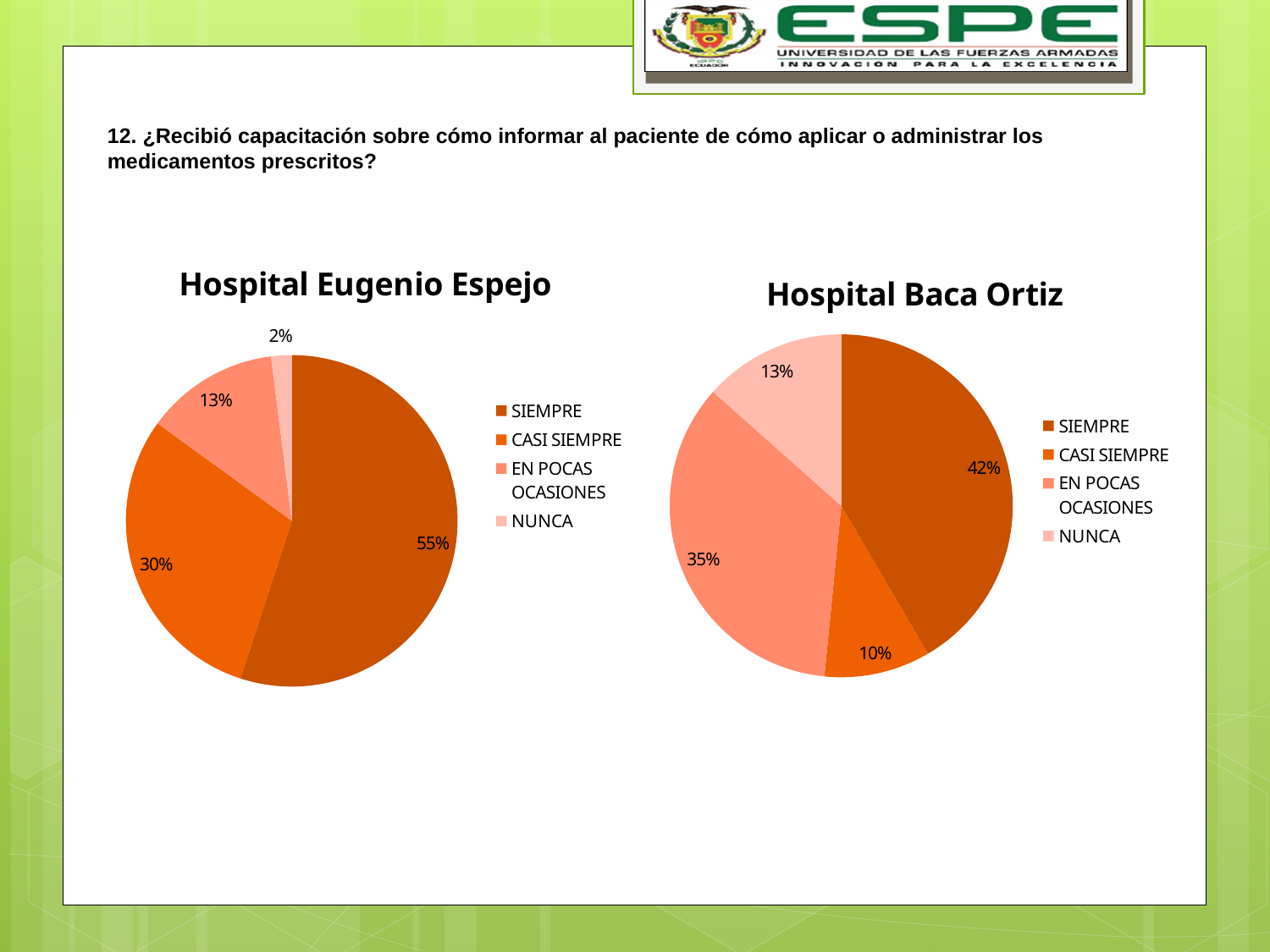
In the Hospital Eugenio Espejo chart, which category has the smallest slice? NUNCA How many categories does the Hospital Baca Ortiz chart show? 4 In the Hospital Baca Ortiz chart, what share is labelled for CASI SIEMPRE? 10% What is the title of the chart on the right side of the slide? Hospital Baca Ortiz In the Hospital Baca Ortiz chart, which category has the largest slice? SIEMPRE In the Hospital Eugenio Espejo chart, what share is labelled for NUNCA? 2% In the Hospital Baca Ortiz chart, what share is labelled for EN POCAS OCASIONES? 35% In the Hospital Baca Ortiz chart, what is the difference between the SIEMPRE and NUNCA shares? 29% In the Hospital Eugenio Espejo chart, what share is labelled for SIEMPRE? 55% Which chart shows a larger share for SIEMPRE, Hospital Eugenio Espejo or Hospital Baca Ortiz? Hospital Eugenio Espejo In the Hospital Eugenio Espejo chart, what is the difference between the SIEMPRE and CASI SIEMPRE shares? 25% What kind of chart is the Hospital Eugenio Espejo chart? Pie chart